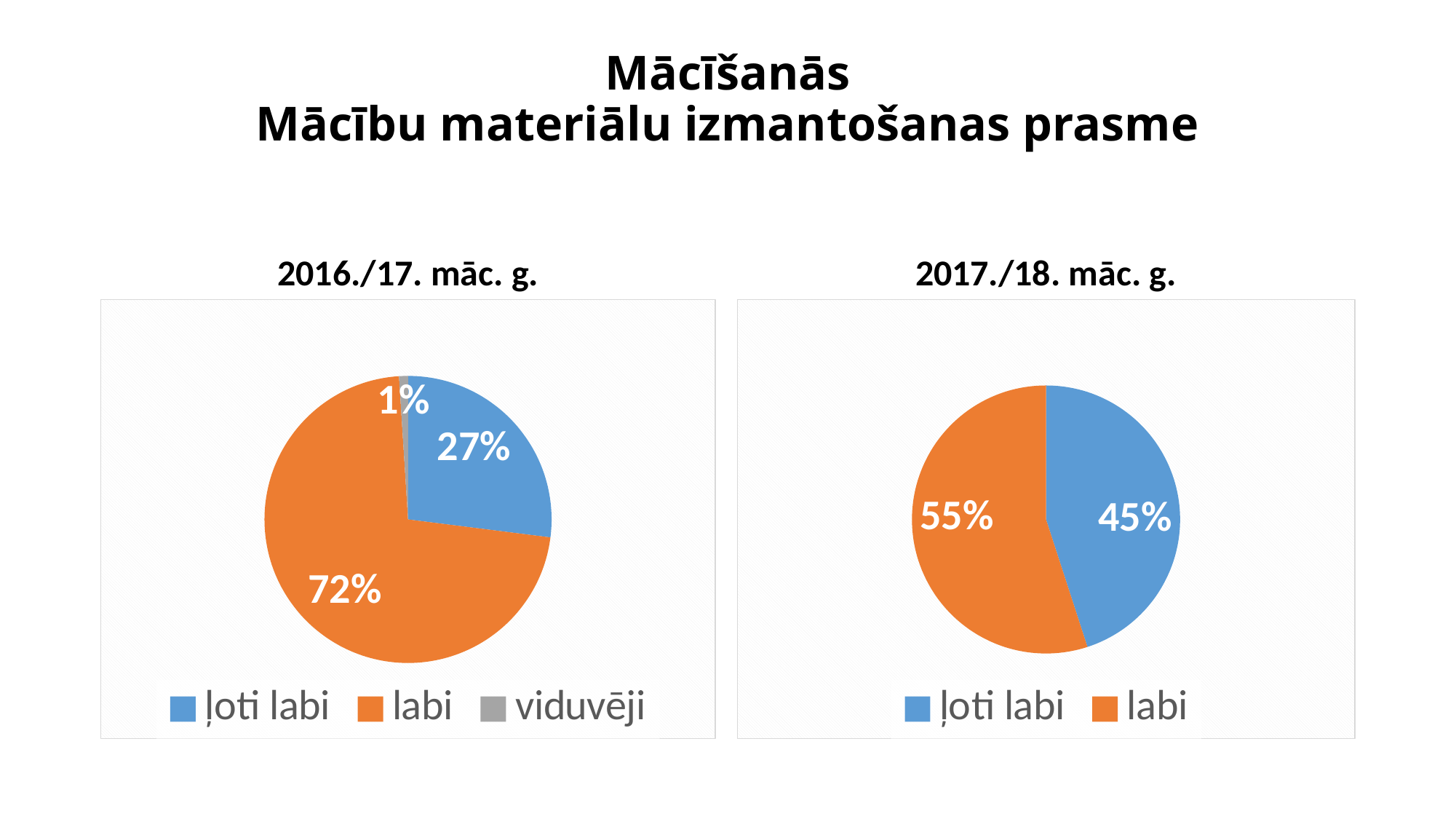
How many categories does the legend of the 2016./17. māc. g. chart list? 3 In the 2016./17. māc. g. chart, what share does "labi" have? 72% In the 2017./18. māc. g. chart, what is the difference between the "labi" and "ļoti labi" shares? 10% What kind of chart is the 2017./18. māc. g. chart? pie chart In the 2016./17. māc. g. chart, which category has the largest slice? labi In the 2016./17. māc. g. chart, what share does "ļoti labi" have? 27% In the 2016./17. māc. g. chart, which category has the smallest slice? viduvēji In the 2017./18. māc. g. chart, what share does "labi" have? 55% In the 2017./18. māc. g. chart, what share does "ļoti labi" have? 45% In the 2017./18. māc. g. chart, which category has the larger slice? labi In the 2016./17. māc. g. chart, what share does "viduvēji" have? 1% How many slices does the 2017./18. māc. g. chart have? 2